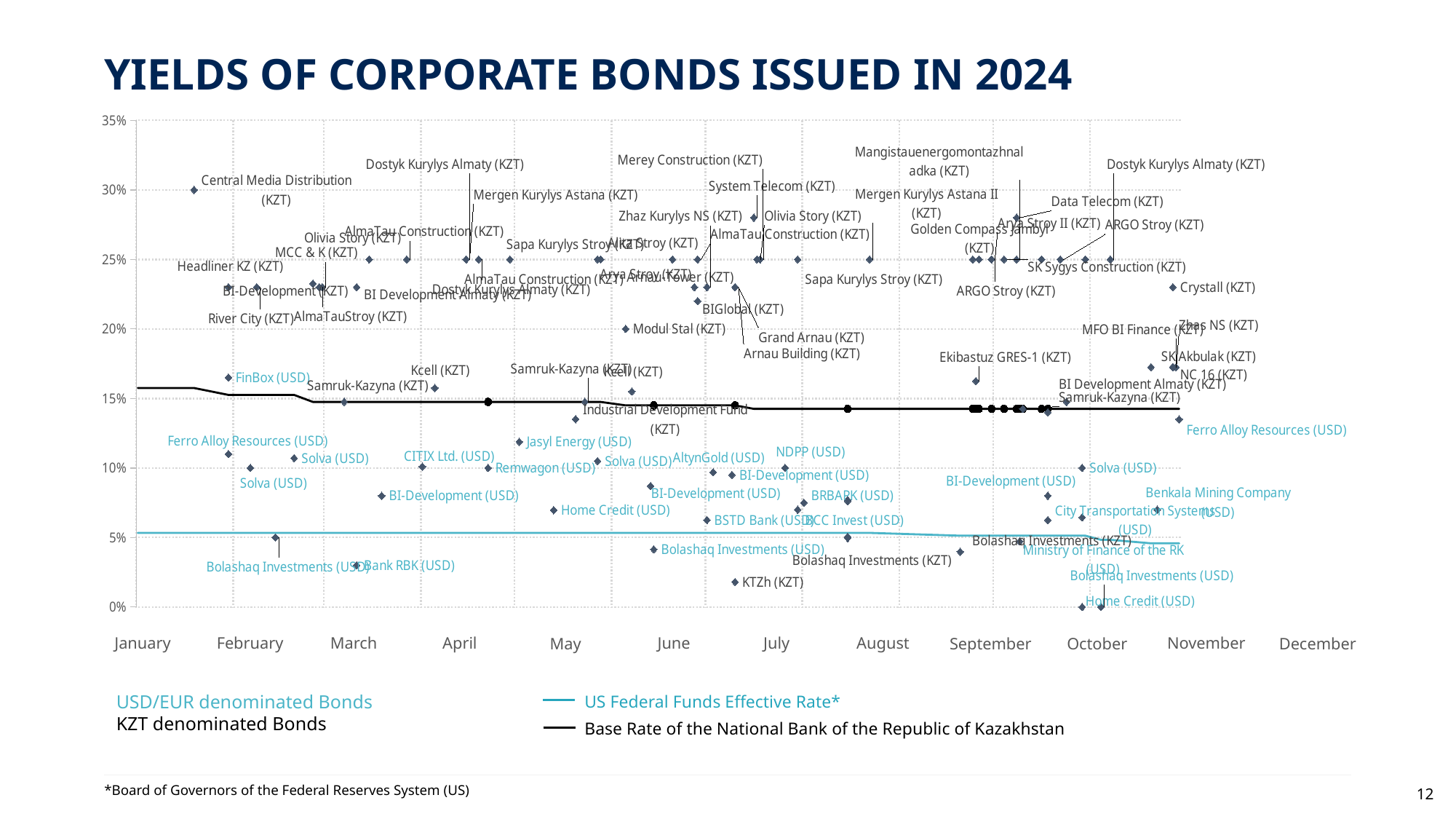
Does the Base Rate of the National Bank of the Republic of Kazakhstan line rise or fall from January to December? fall Is the yield of the Crystall (KZT) bond greater or less than 20%? greater Which is higher, the yield of Central Media Distribution (KZT) or the yield of Modul Stal (KZT)? Central Media Distribution (KZT) What kind of chart is shown on the slide? scatter chart Is the yield of the Ekibastuz GRES-1 (KZT) bond greater or less than 15%? greater Is the yield of the Home Credit (USD) bond issued in May greater or less than 10%? less What is the yield of the Modul Stal (KZT) bond? 20% What is the yield of the Central Media Distribution (KZT) bond? 30% How many entries does the legend below the chart list? 4 What is the title of the chart? YIELDS OF CORPORATE BONDS ISSUED IN 2024 Which bond has the highest yield on the chart? Central Media Distribution (KZT)